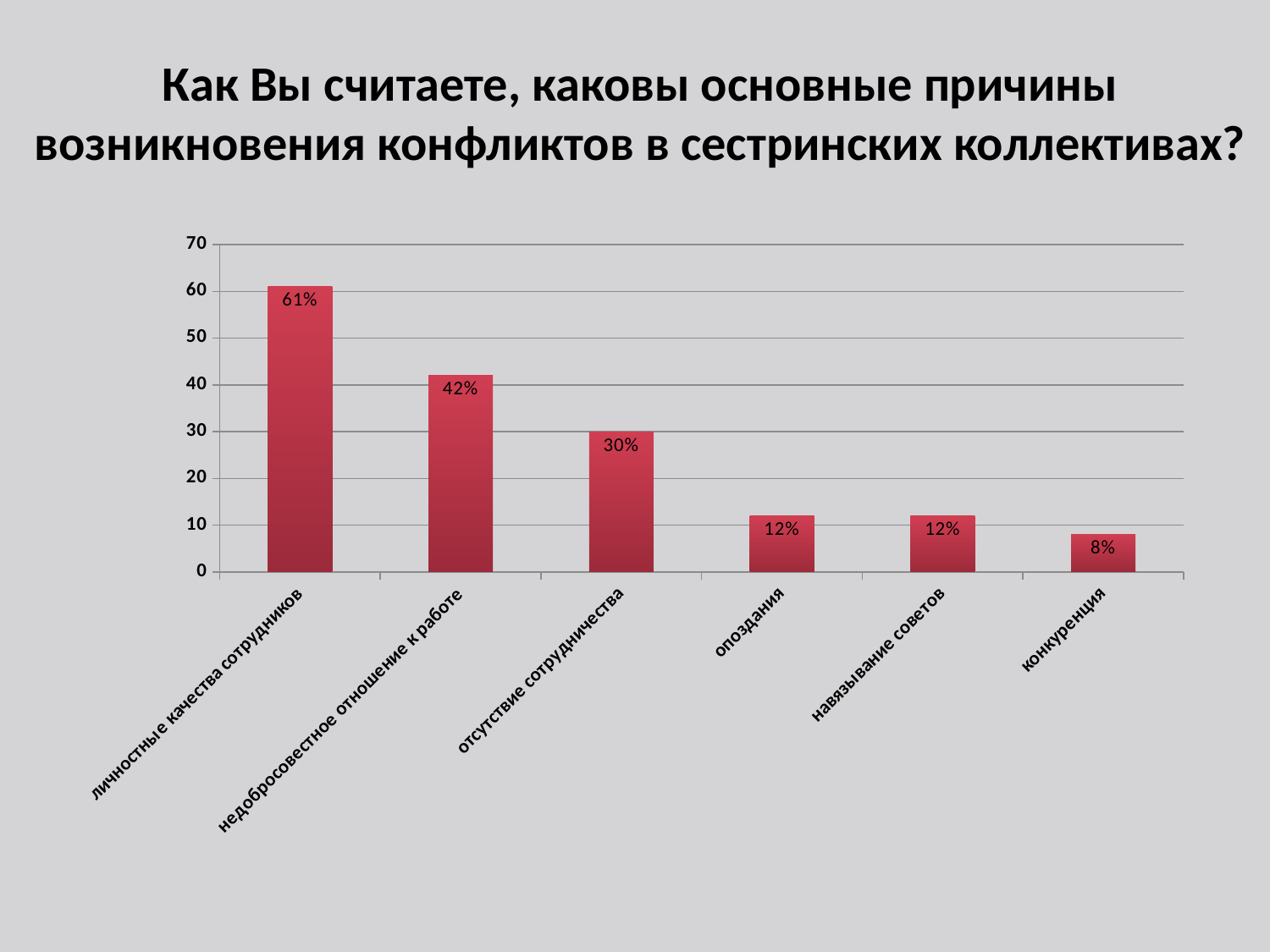
What is the value for конкуренция? 8% Which category has the lowest value? конкуренция What is the difference between the values for личностные качества сотрудников and недобросовестное отношение к работе? 19% Is the value for недобросовестное отношение к работе greater or less than 40? greater Do the values rise or fall from left to right along the x axis? fall What kind of chart is shown on the slide? bar chart Which is larger, the value for отсутствие сотрудничества or the value for опоздания? отсутствие сотрудничества Which category has the highest value? личностные качества сотрудников What is the value for недобросовестное отношение к работе? 42% What is the value for личностные качества сотрудников? 61% How many categories are shown on the chart? 6 What is the value for отсутствие сотрудничества? 30%